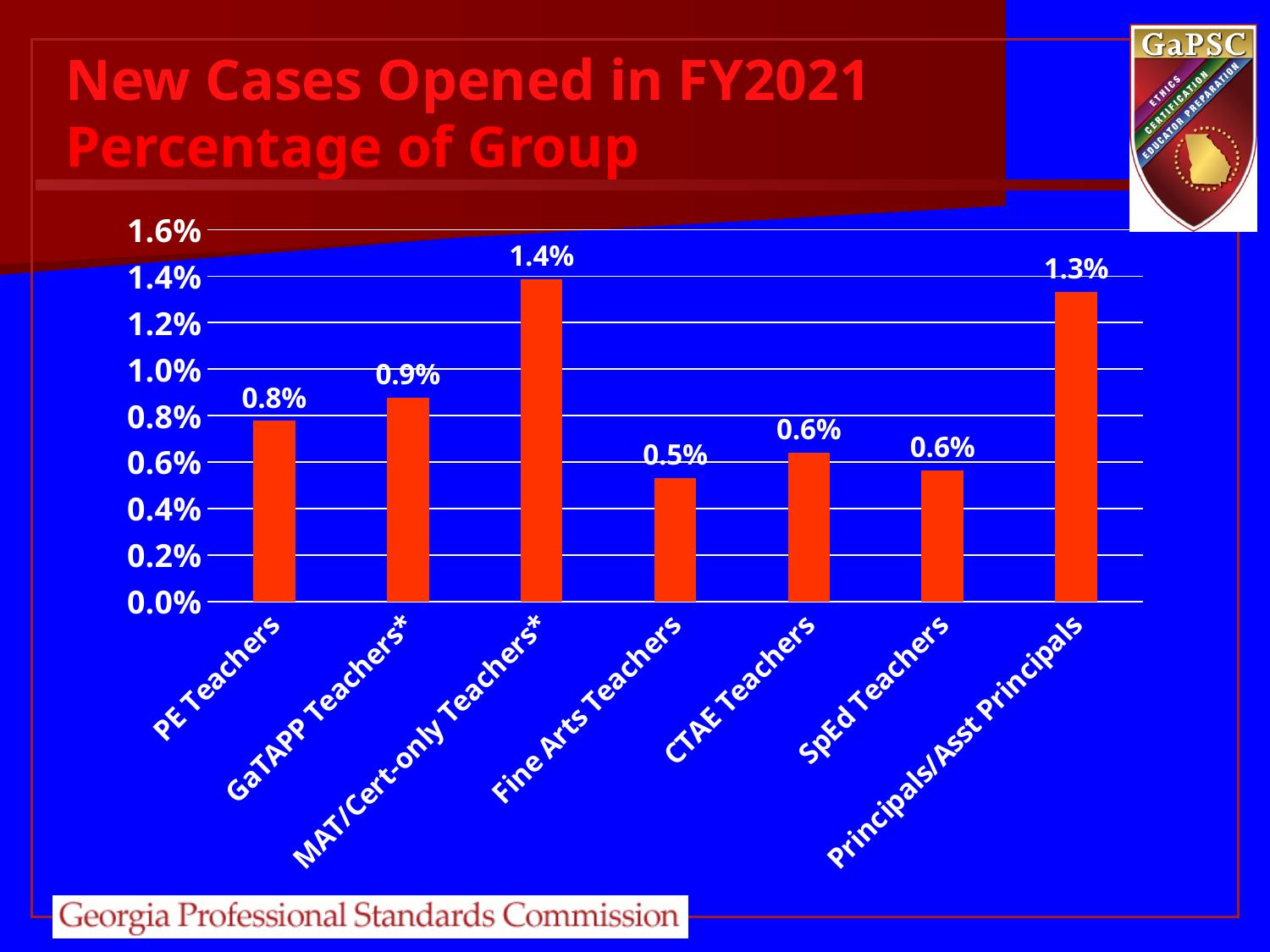
Is the value for Principals/Asst Principals greater or less than 1.0%? greater How many categories are shown on the x axis? 7 What is the value for Principals/Asst Principals? 1.3% What is the value for Fine Arts Teachers? 0.5% What is the difference between the values for MAT/Cert-only Teachers* and PE Teachers? 0.6% What kind of chart is shown on the slide? bar chart What is the title of the chart? New Cases Opened in FY2021 Percentage of Group Which is larger, the value for GaTAPP Teachers* or the value for CTAE Teachers? GaTAPP Teachers* Which category has the lowest value? Fine Arts Teachers Which category has the highest value? MAT/Cert-only Teachers* What is the value for PE Teachers? 0.8% What is the value for MAT/Cert-only Teachers*? 1.4%